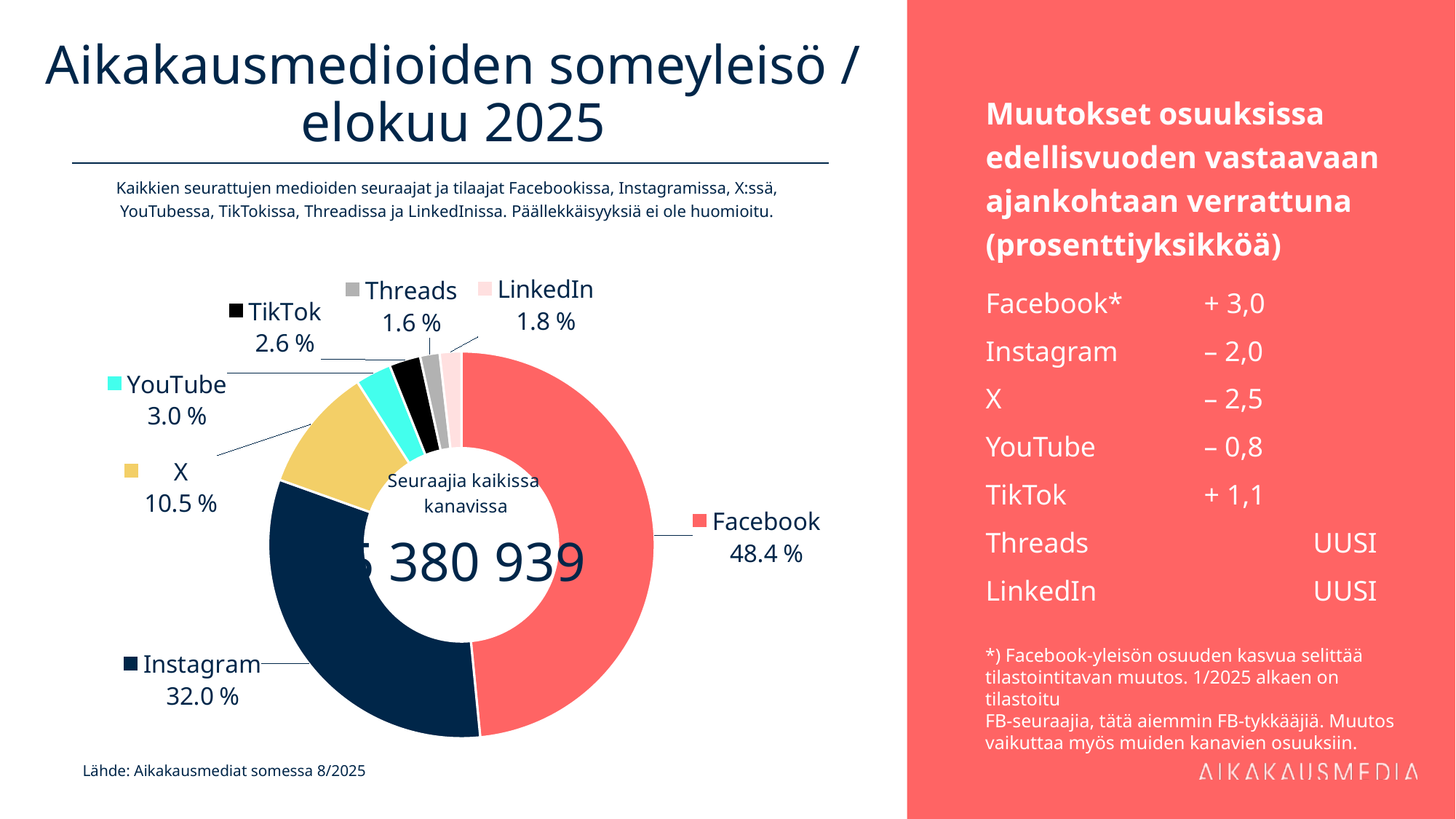
Which has a larger share, YouTube or TikTok? YouTube What is the value shown for TikTok in the chart? 2.6 % What is the value shown for X in the chart? 10.5 % What is the value shown for Instagram in the chart? 32.0 % What colour is the Facebook slice in the chart? Red (coral) Which has a larger share, LinkedIn or Threads? LinkedIn How many channels (slices) are shown in the chart? 7 What share of the donut chart does Facebook hold? 48.4 % Which channel has the largest share in the chart? Facebook Which channel has the smallest share in the chart? Threads What is the difference in percentage points between Facebook's and Instagram's shares? 16.4 What kind of chart is shown on the slide? Donut (pie) chart